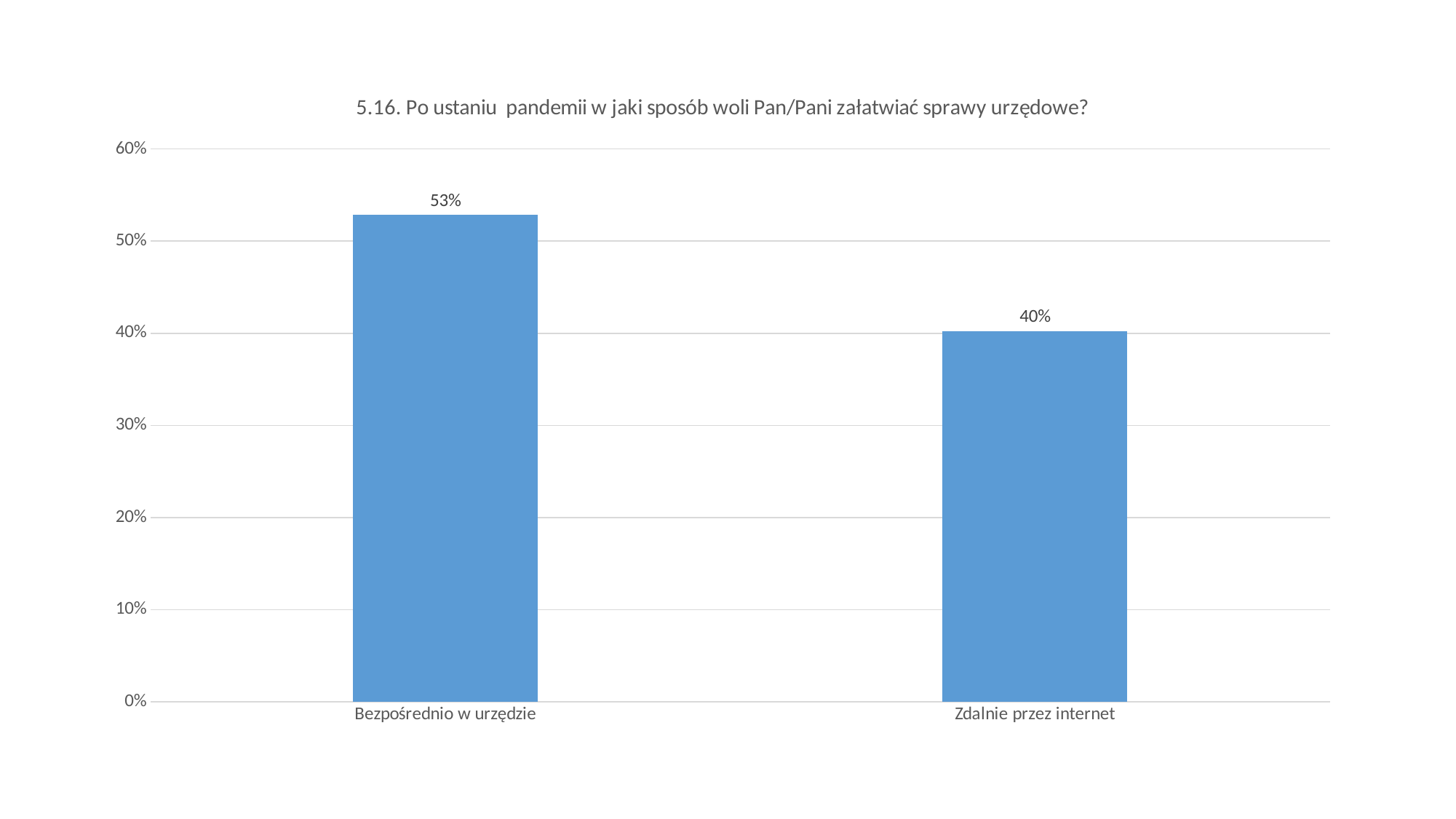
Is the value for "Zdalnie przez internet" greater or less than 50%? less What is the title of the chart? 5.16. Po ustaniu pandemii w jaki sposób woli Pan/Pani załatwiać sprawy urzędowe? Which category has the highest value? Bezpośrednio w urzędzie What is the value for "Zdalnie przez internet"? 40% What is the difference between the values for "Bezpośrednio w urzędzie" and "Zdalnie przez internet"? 13% Which category has the lowest value? Zdalnie przez internet What is the highest value shown on the vertical axis? 60% How many categories are shown on the chart? 2 Which is larger, the value for "Bezpośrednio w urzędzie" or the value for "Zdalnie przez internet"? Bezpośrednio w urzędzie What is the value for "Bezpośrednio w urzędzie"? 53% Is the value for "Bezpośrednio w urzędzie" greater or less than 50%? greater What kind of chart is shown on the slide? bar chart